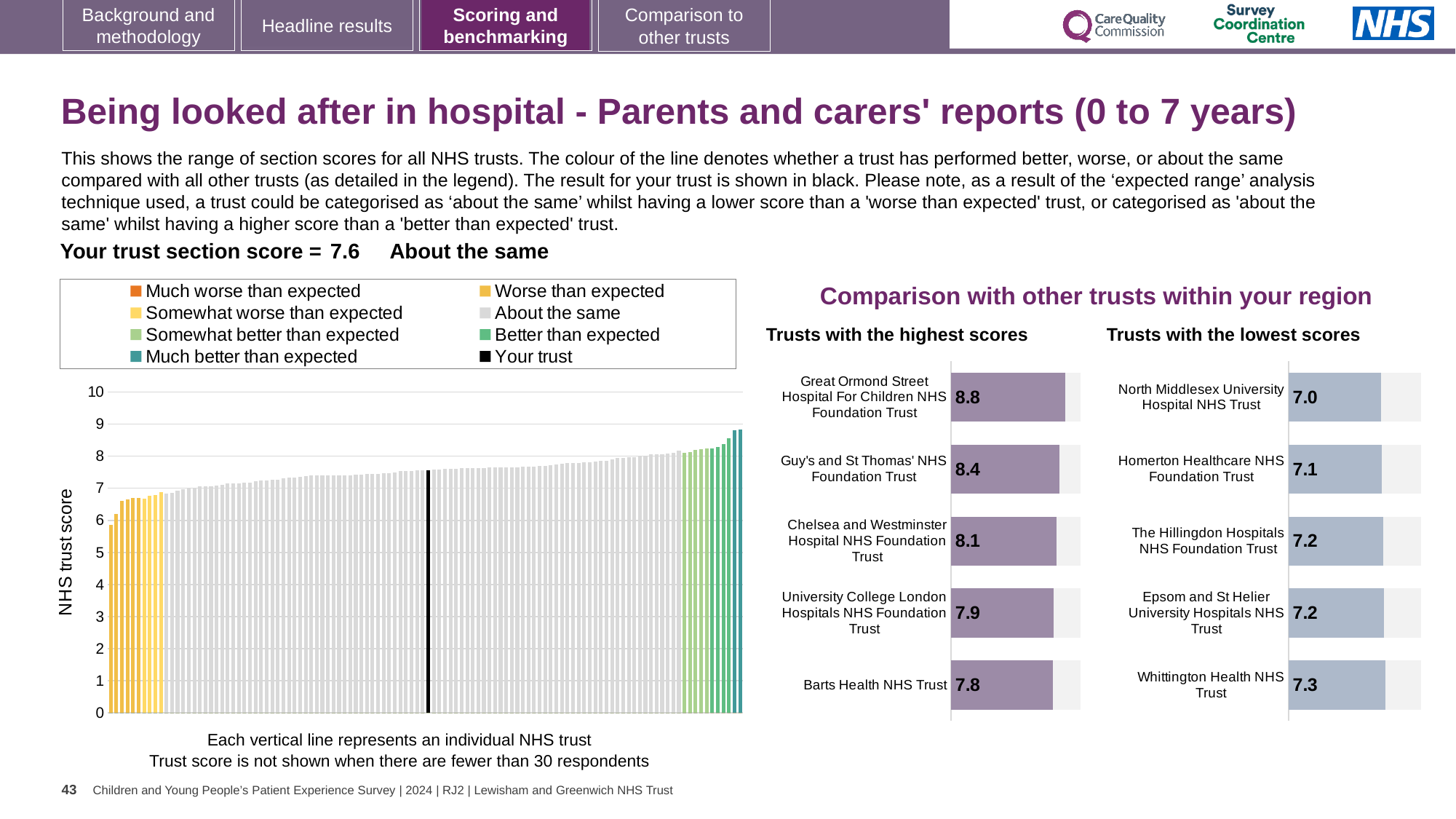
In the 'Trusts with the highest scores' chart, what is the score for Great Ormond Street Hospital For Children NHS Foundation Trust? 8.8 In the 'Trusts with the highest scores' chart, what is the difference between the scores of Great Ormond Street Hospital For Children NHS Foundation Trust and Barts Health NHS Trust? 1.0 In the main chart on the left, is the value of the tallest bar greater or less than 8? greater In the 'Trusts with the highest scores' chart, which trust has the lowest score shown? Barts Health NHS Trust How many entries does the legend of the main chart on the left list? 8 In the 'Trusts with the lowest scores' chart, what is the score for Homerton Healthcare NHS Foundation Trust? 7.1 In the 'Trusts with the lowest scores' chart, what is the difference between the scores of Whittington Health NHS Trust and North Middlesex University Hospital NHS Trust? 0.3 In the 'Trusts with the highest scores' chart, which has the higher score: Guy's and St Thomas' NHS Foundation Trust or Chelsea and Westminster Hospital NHS Foundation Trust? Guy's and St Thomas' NHS Foundation Trust In the 'Trusts with the lowest scores' chart, which trust has the lowest score? North Middlesex University Hospital NHS Trust In the main chart on the left, do the bar values rise or fall from left to right? rise How many trusts are listed in the 'Trusts with the lowest scores' chart? 5 In the main chart on the left, what is the section score for your trust (the black bar)? 7.6